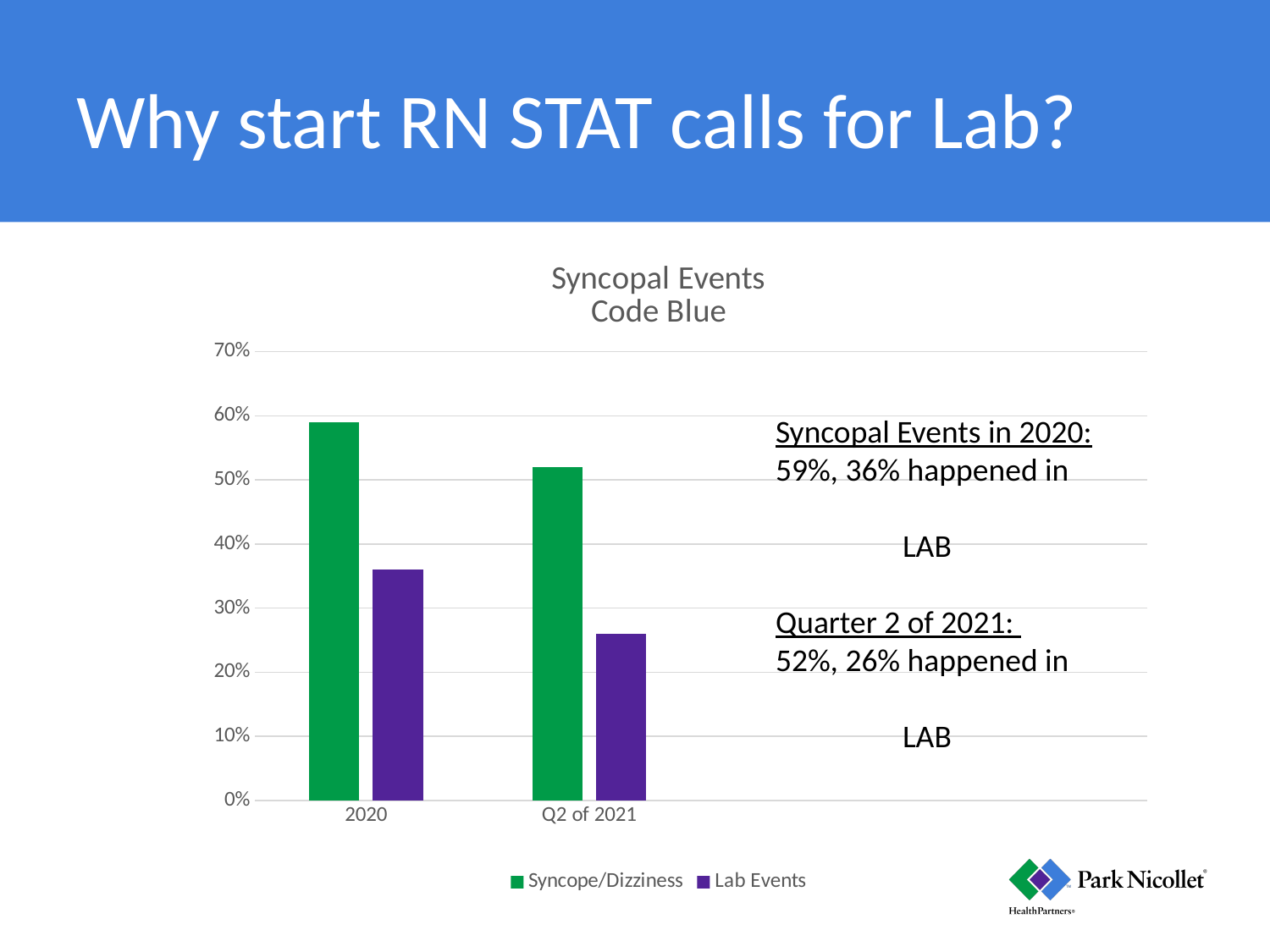
What is the Syncope/Dizziness value for Q2 of 2021? 52% How many series does the chart legend list? 2 What is the title of the chart? Syncopal Events Code Blue What is the difference between the Syncope/Dizziness value and the Lab Events value for 2020? 23% What is the Lab Events value for Q2 of 2021? 26% What type of chart is shown on the slide? Bar chart Does the Lab Events value rise or fall from 2020 to Q2 of 2021? Fall Which category has the higher Syncope/Dizziness value, 2020 or Q2 of 2021? 2020 What is the Syncope/Dizziness value for 2020? 59% What is the Lab Events value for 2020? 36% How many categories are shown on the x axis of the chart? 2 Is the Lab Events value for Q2 of 2021 greater or less than 30%? less